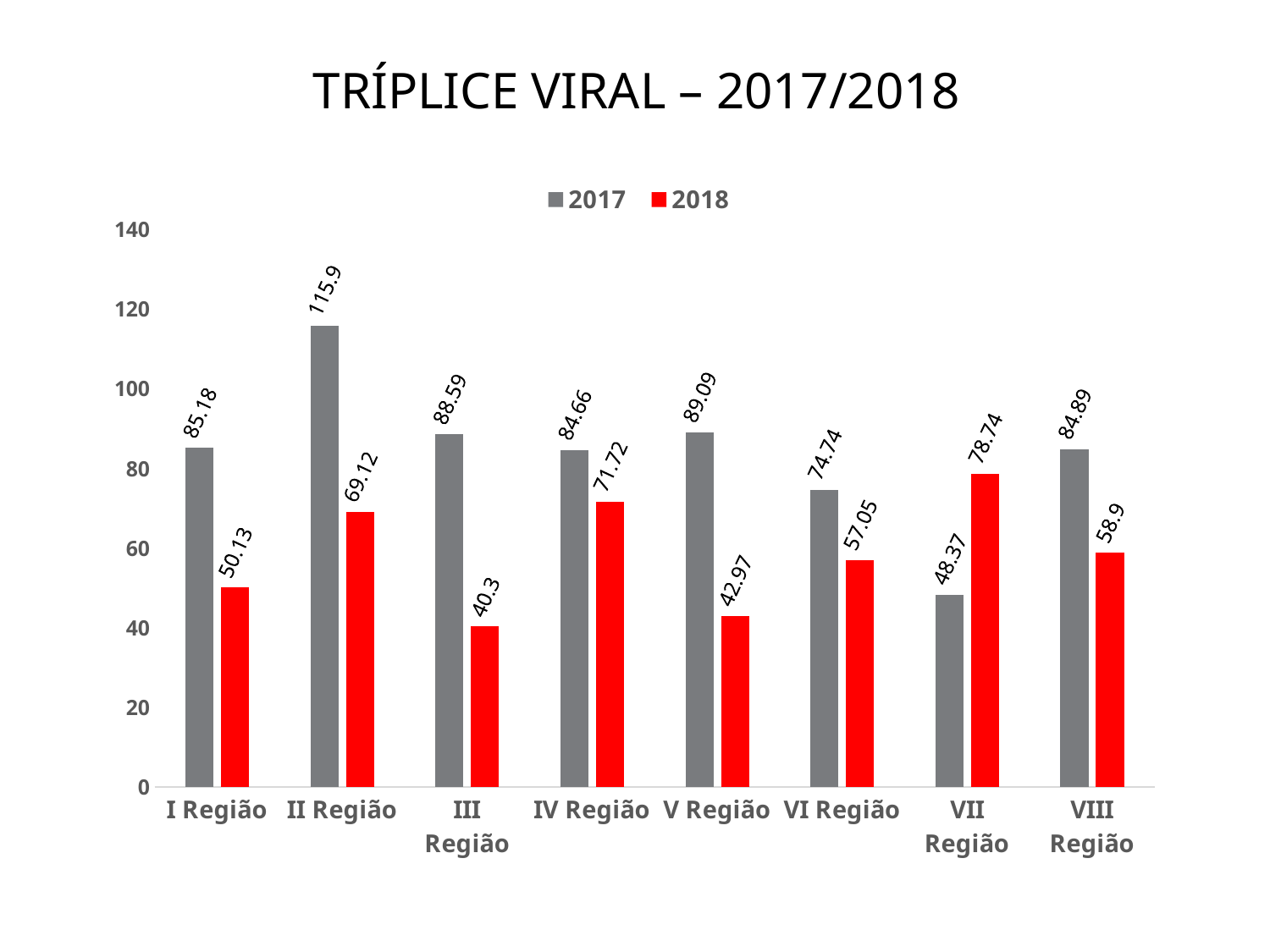
Which region has the highest 2017 value? II Região What is the 2017 value for II Região? 115.9 Is the 2017 value for VI Região greater or less than 80? less How many series does the legend list? 2 What kind of chart is shown on the slide? bar chart What is the 2018 value for III Região? 40.3 What is the 2018 value for VII Região? 78.74 What is the difference between the 2017 and 2018 values for I Região? 35.05 Which region has the lowest 2018 value? III Região What is the title of the chart? TRÍPLICE VIRAL – 2017/2018 How many regions are shown on the x axis? 8 Which is larger for VII Região, the 2017 value or the 2018 value? 2018